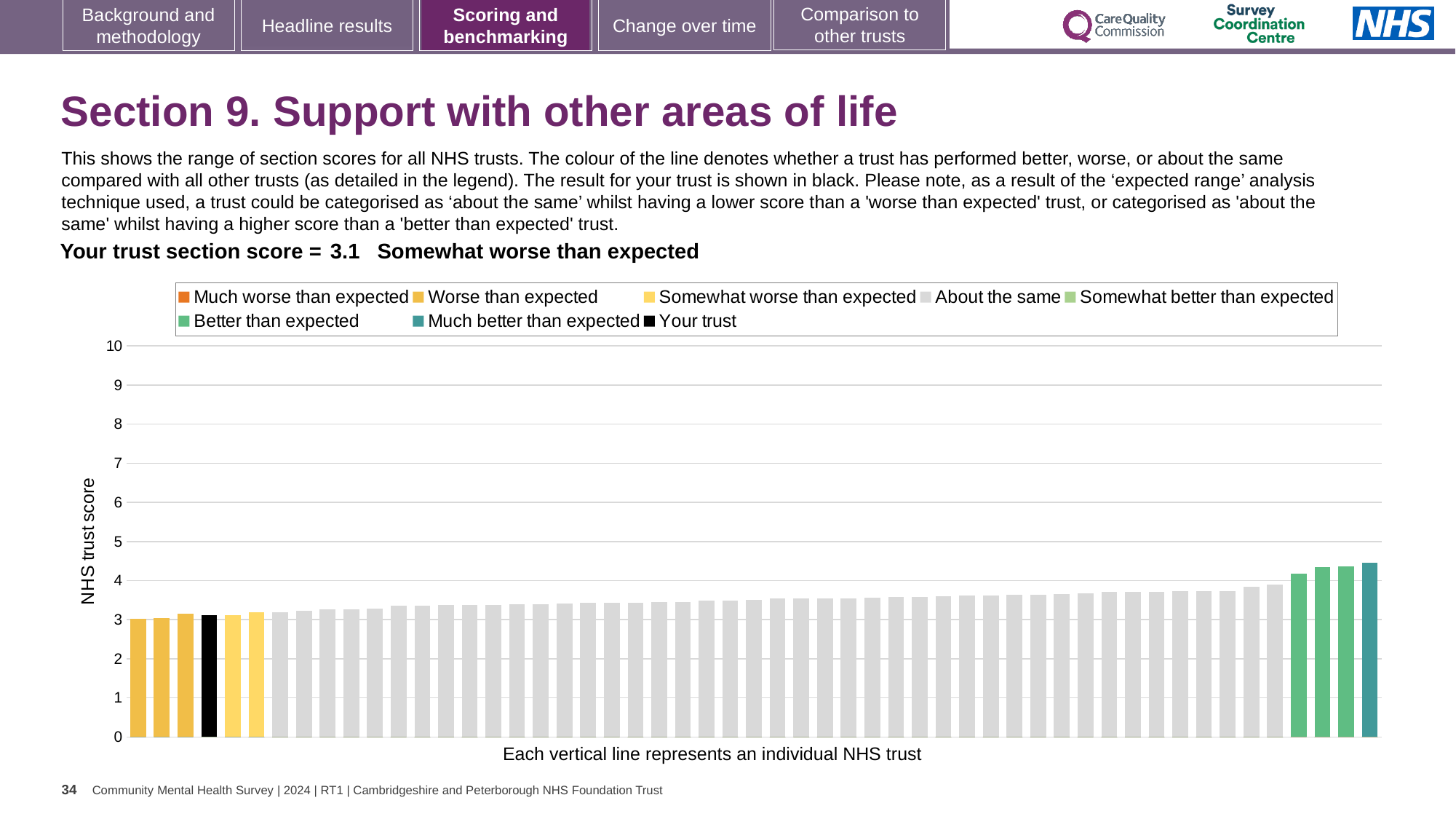
How many entries does the chart legend list? 8 What colour is the bar representing your trust? black What is the highest value shown on the y axis? 10 Is the value of the shortest bar (leftmost trust) greater or less than 2? greater What is the section score for your trust shown on the slide? 3.1 Is the value for your trust greater or less than 4? less What kind of chart is shown on the slide? bar chart Is the value of the tallest bar (rightmost trust) greater or less than 4? greater Do the bar values rise or fall from left to right across the chart? rise Which performance category is your trust's section score placed in? Somewhat worse than expected